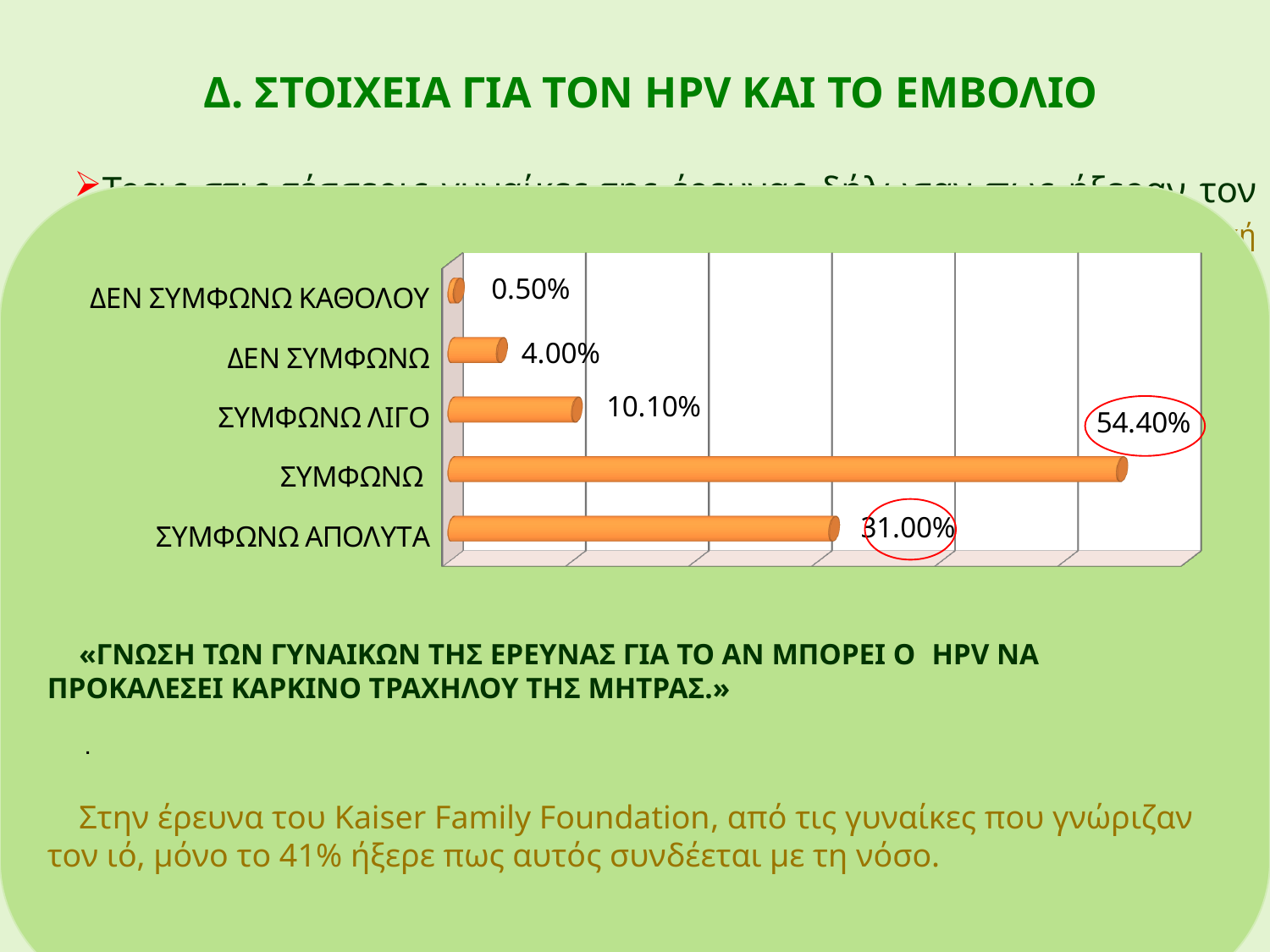
Which is larger, the value for ΣΥΜΦΩΝΩ ΛΙΓΟ or the value for ΔΕΝ ΣΥΜΦΩΝΩ? ΣΥΜΦΩΝΩ ΛΙΓΟ What is the value for ΔΕΝ ΣΥΜΦΩΝΩ? 4.00% How many categories are shown in the chart? 5 What is the value for ΣΥΜΦΩΝΩ ΑΠΟΛΥΤΑ? 31.00% What colour are the bars in the chart? Orange What is the difference between the values for ΣΥΜΦΩΝΩ and ΣΥΜΦΩΝΩ ΑΠΟΛΥΤΑ? 23.40% Which category has the lowest value? ΔΕΝ ΣΥΜΦΩΝΩ ΚΑΘΟΛΟΥ Which category has the highest value? ΣΥΜΦΩΝΩ What kind of chart is shown on the slide? Bar chart What is the value for ΔΕΝ ΣΥΜΦΩΝΩ ΚΑΘΟΛΟΥ? 0.50% What is the value for ΣΥΜΦΩΝΩ? 54.40% What is the value for ΣΥΜΦΩΝΩ ΛΙΓΟ? 10.10%